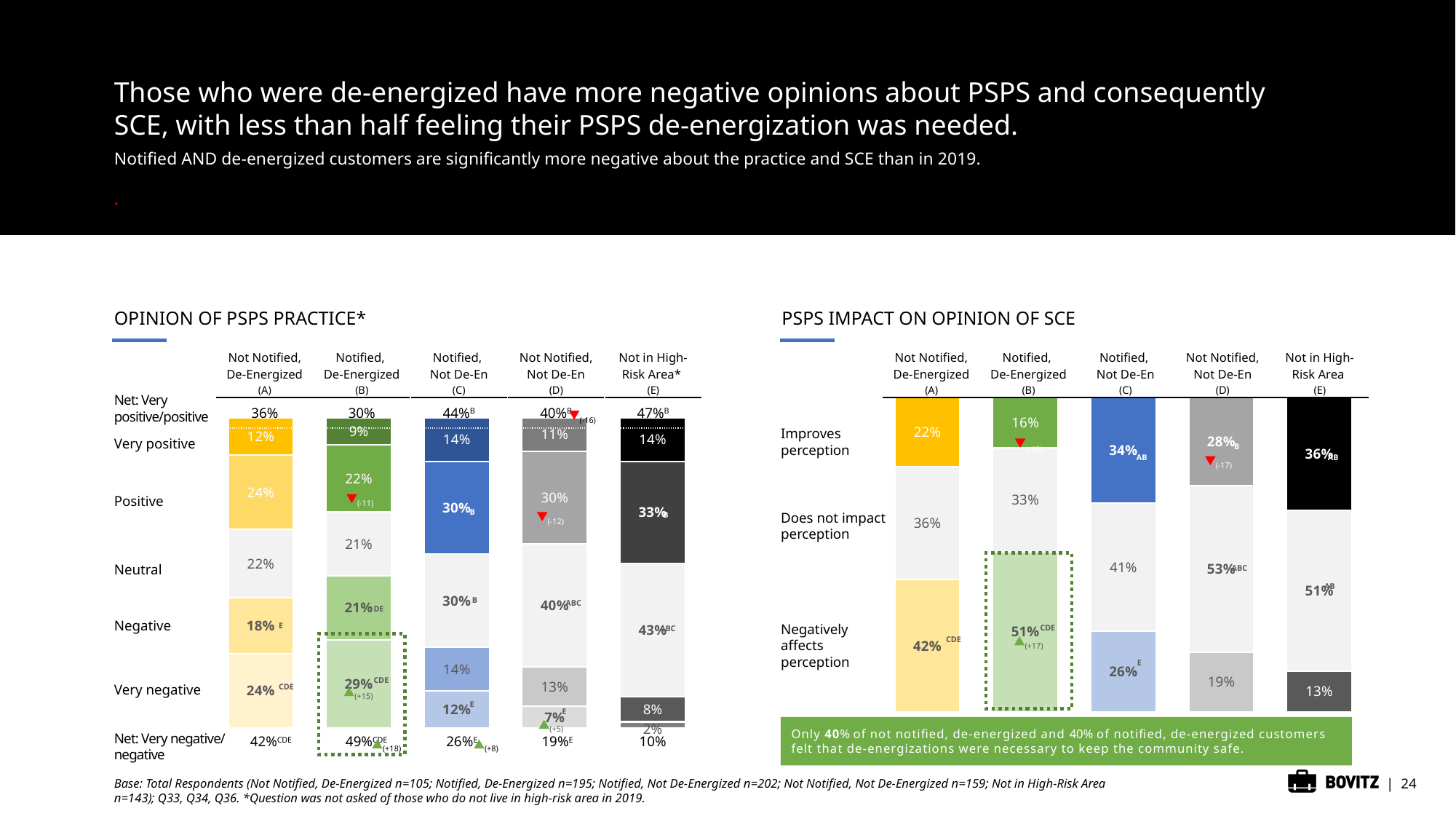
In the 'PSPS IMPACT ON OPINION OF SCE' chart, what is the difference between the 'Negatively affects perception' shares for Not Notified, De-Energized (A) and Notified, Not De-En (C)? 16 percentage points In the 'PSPS IMPACT ON OPINION OF SCE' chart, which group has the highest 'Improves perception' share? Not in High-Risk Area (E) In the 'OPINION OF PSPS PRACTICE' chart, what percentage of Notified, De-Energized customers (B) are Very negative? 29% In the 'OPINION OF PSPS PRACTICE' chart, which group has the lowest Net: Very positive/positive value? Notified, De-Energized (B) In the 'OPINION OF PSPS PRACTICE' chart, which group has the highest Neutral share? Not in High-Risk Area (E) What type of chart is used for 'PSPS IMPACT ON OPINION OF SCE'? Stacked bar chart In the 'PSPS IMPACT ON OPINION OF SCE' chart, what percentage of Notified, De-Energized customers (B) say PSPS negatively affects perception? 51% In the 'OPINION OF PSPS PRACTICE' chart, what is the difference between the Net: Very negative/negative values for Notified, De-Energized (B) and Notified, Not De-En (C)? 23 percentage points In the 'OPINION OF PSPS PRACTICE' chart, what is the Net: Very negative/negative value for Not Notified, De-Energized customers (A)? 42% In the 'PSPS IMPACT ON OPINION OF SCE' chart, is the 'Does not impact perception' share larger for Not Notified, Not De-En (D) or for Notified, Not De-En (C)? Not Notified, Not De-En (D) In the 'PSPS IMPACT ON OPINION OF SCE' chart, which group has the lowest 'Negatively affects perception' share? Not in High-Risk Area (E) How many customer groups are shown in the 'OPINION OF PSPS PRACTICE' chart? 5